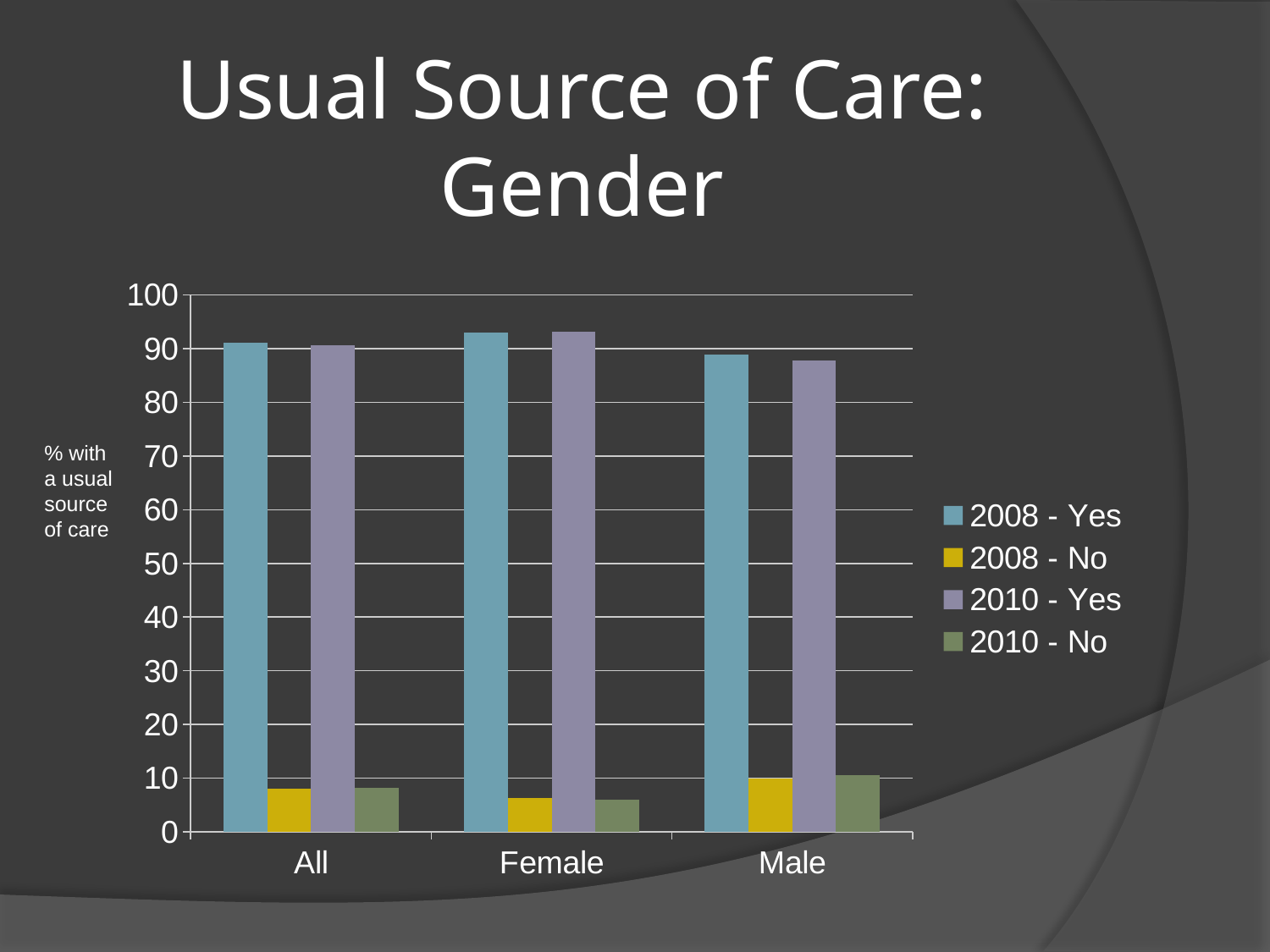
Is the value for Female in the 2010 - Yes series greater or less than 90? greater Is the value for Male in the 2008 - No series greater or less than 20? less Is the value for All in the 2008 - Yes series greater or less than 80? greater Which category has the lowest value for the 2008 - Yes series? Male What is the label on the vertical axis of the chart? % with a usual source of care Which category has the highest value for the 2008 - No series? Male What kind of chart is shown on the slide? bar chart Which category has the lowest value for the 2010 - No series? Female How many categories are shown on the x axis? 3 How many series does the legend list? 4 Which is larger for the 2008 - Yes series: Female or Male? Female